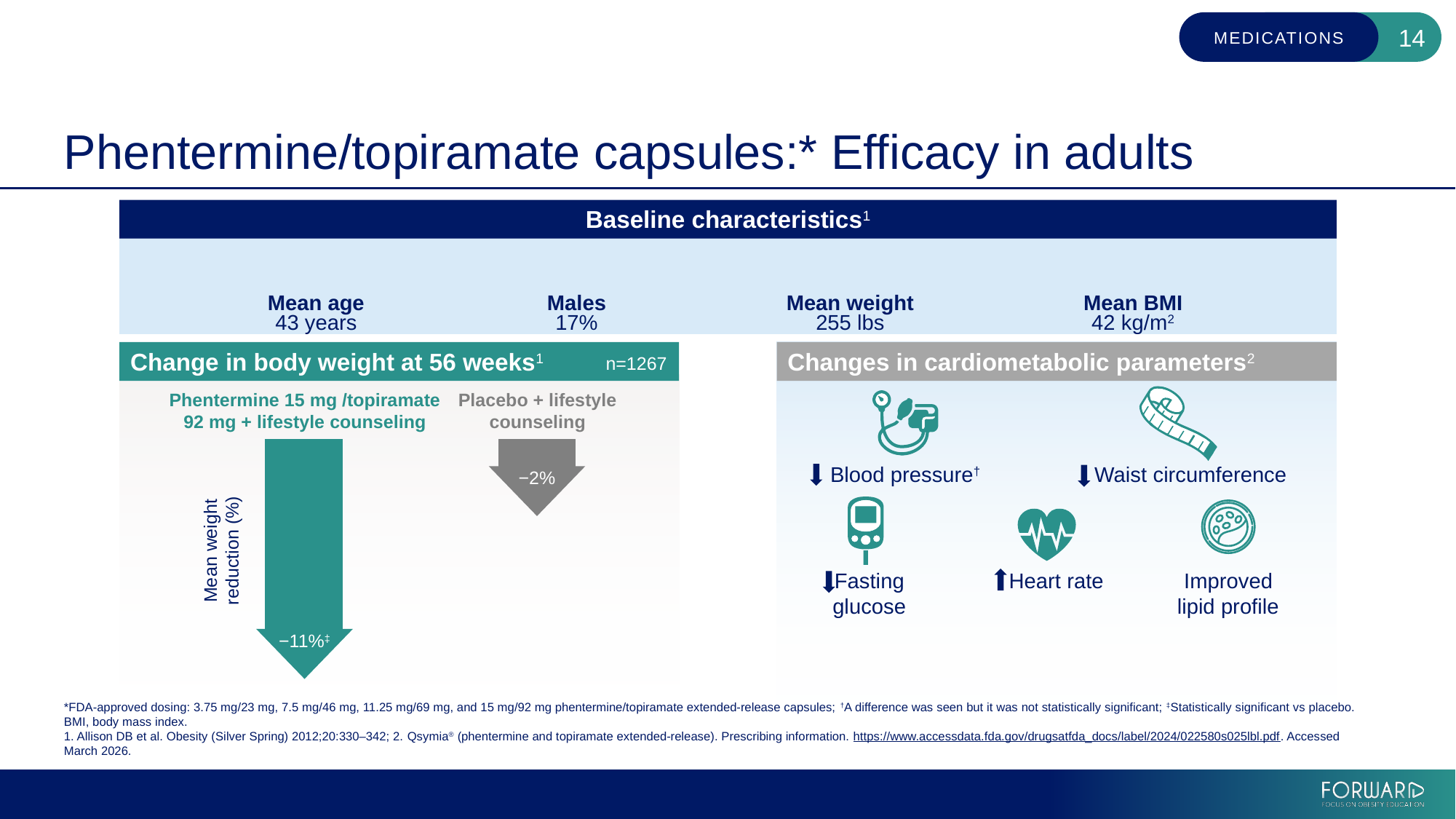
In the 'Change in body weight at 56 weeks' chart, which value carries the ‡ symbol indicating statistical significance vs placebo? −11% In the 'Change in body weight at 56 weeks' chart, which group shows the larger mean weight reduction? Phentermine 15 mg/topiramate 92 mg + lifestyle counseling In the 'Change in body weight at 56 weeks' chart, what is the mean weight reduction for phentermine 15 mg/topiramate 92 mg + lifestyle counseling? −11% In the 'Change in body weight at 56 weeks' chart, which group shows the smaller mean weight reduction? Placebo + lifestyle counseling In the 'Change in body weight at 56 weeks' chart, what is the mean weight reduction for placebo + lifestyle counseling? −2% In the 'Change in body weight at 56 weeks' chart, what is the difference in mean weight reduction between the phentermine/topiramate group and the placebo group? 9 percentage points What is the label on the vertical axis of the 'Change in body weight at 56 weeks' chart? Mean weight reduction (%) What is the sample size (n) shown for the 'Change in body weight at 56 weeks' chart? n=1267 How many treatment groups are shown in the 'Change in body weight at 56 weeks' chart? 2 In the 'Change in body weight at 56 weeks' chart, is the weight reduction for the phentermine/topiramate group larger or smaller than for the placebo group? Larger